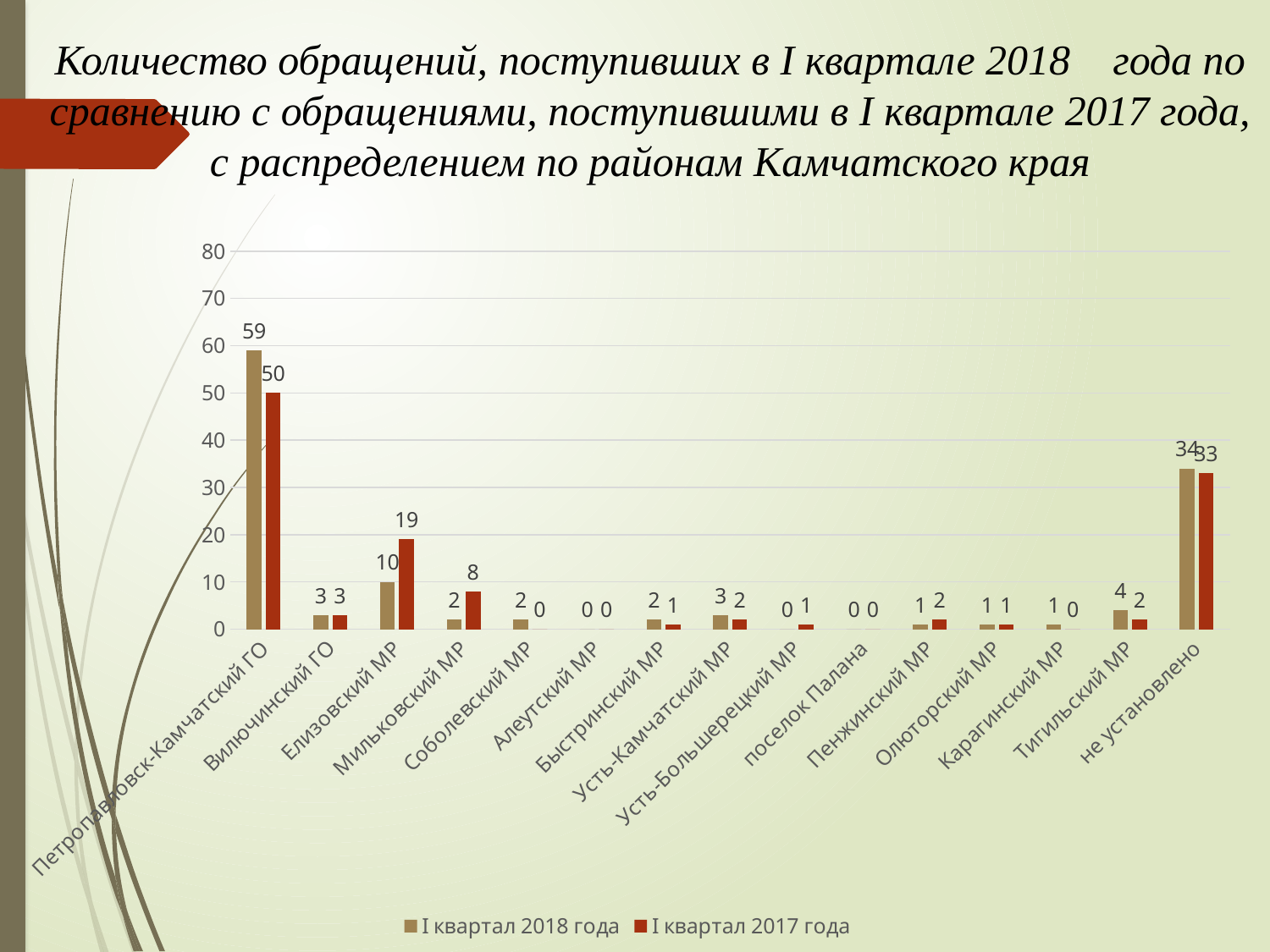
What is the value for Мильковский МР in the series I квартал 2017 года? 8 What is the value for Тигильский МР in the series I квартал 2018 года? 4 What is the value for Петропавловск-Камчатский ГО in the series I квартал 2018 года? 59 How many series does the legend list? 2 What is the difference between the I квартал 2018 года and I квартал 2017 года values for Петропавловск-Камчатский ГО? 9 What is the value for не установлено in the series I квартал 2017 года? 33 Which colour represents the series I квартал 2017 года in the legend? red What kind of chart is shown on the slide? bar chart What is the value for Елизовский МР in the series I квартал 2017 года? 19 Which category has the highest value in the series I квартал 2018 года? Петропавловск-Камчатский ГО For Елизовский МР, which series has the larger value: I квартал 2018 года or I квартал 2017 года? I квартал 2017 года How many categories (districts) are shown on the x axis? 15